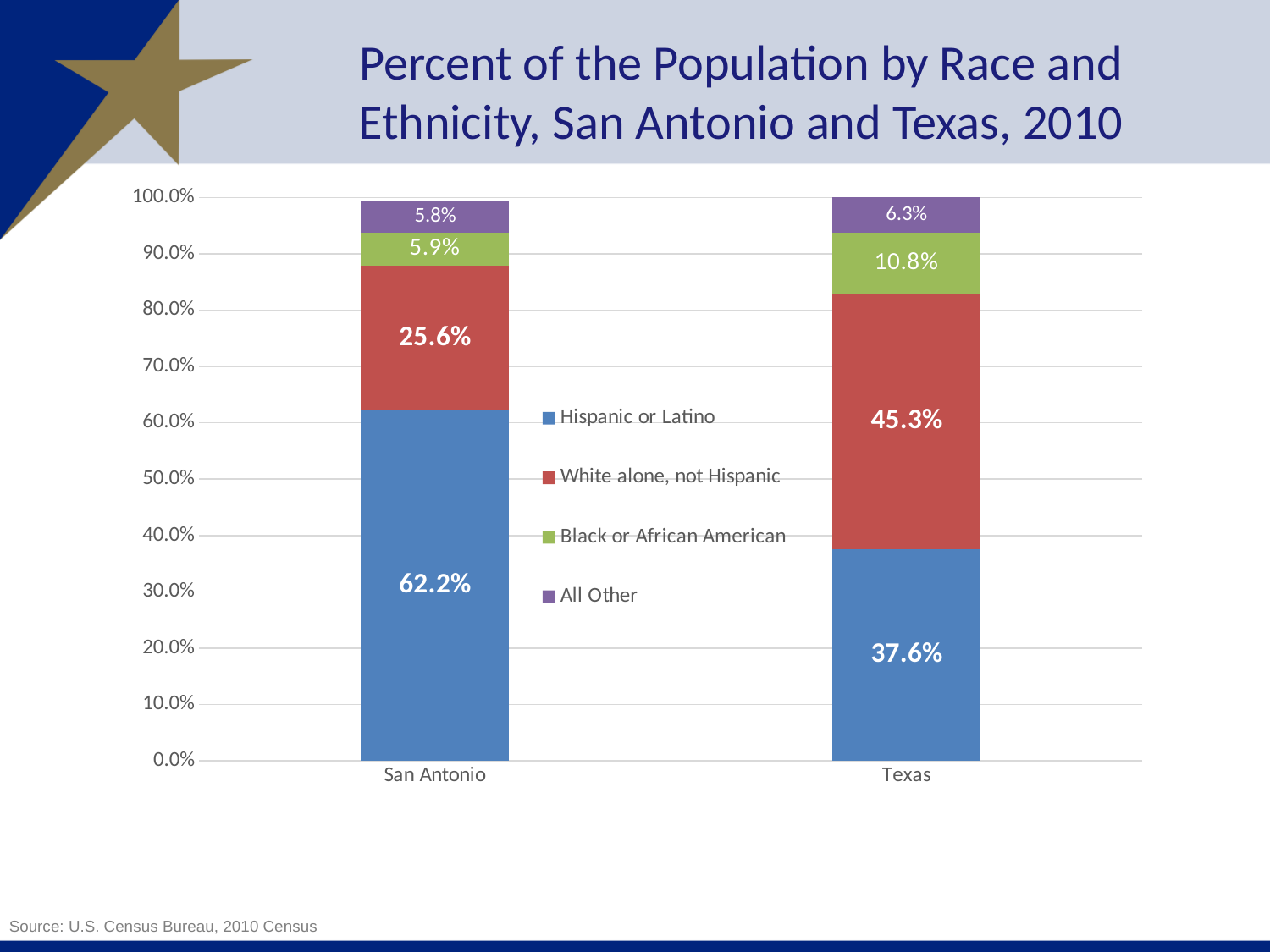
What is the All Other share of the population in San Antonio? 5.8% How many race/ethnicity series does the legend list? 4 Which race/ethnicity group makes up the smallest share of the Texas population? All Other What percentage of Texas's population is White alone, not Hispanic? 45.3% Which has a larger Black or African American share, San Antonio or Texas? Texas How many percentage points higher is the Hispanic or Latino share in San Antonio than in Texas? 24.6 What is the Black or African American share of the population in Texas? 10.8% Which race/ethnicity group makes up the largest share of the Texas population? White alone, not Hispanic What percentage of San Antonio's population is Hispanic or Latino? 62.2% What is the total of the labelled segments in the San Antonio bar? 99.5% What kind of chart is shown on the slide? Stacked bar chart How many geographic areas (bars) are shown in the chart? 2